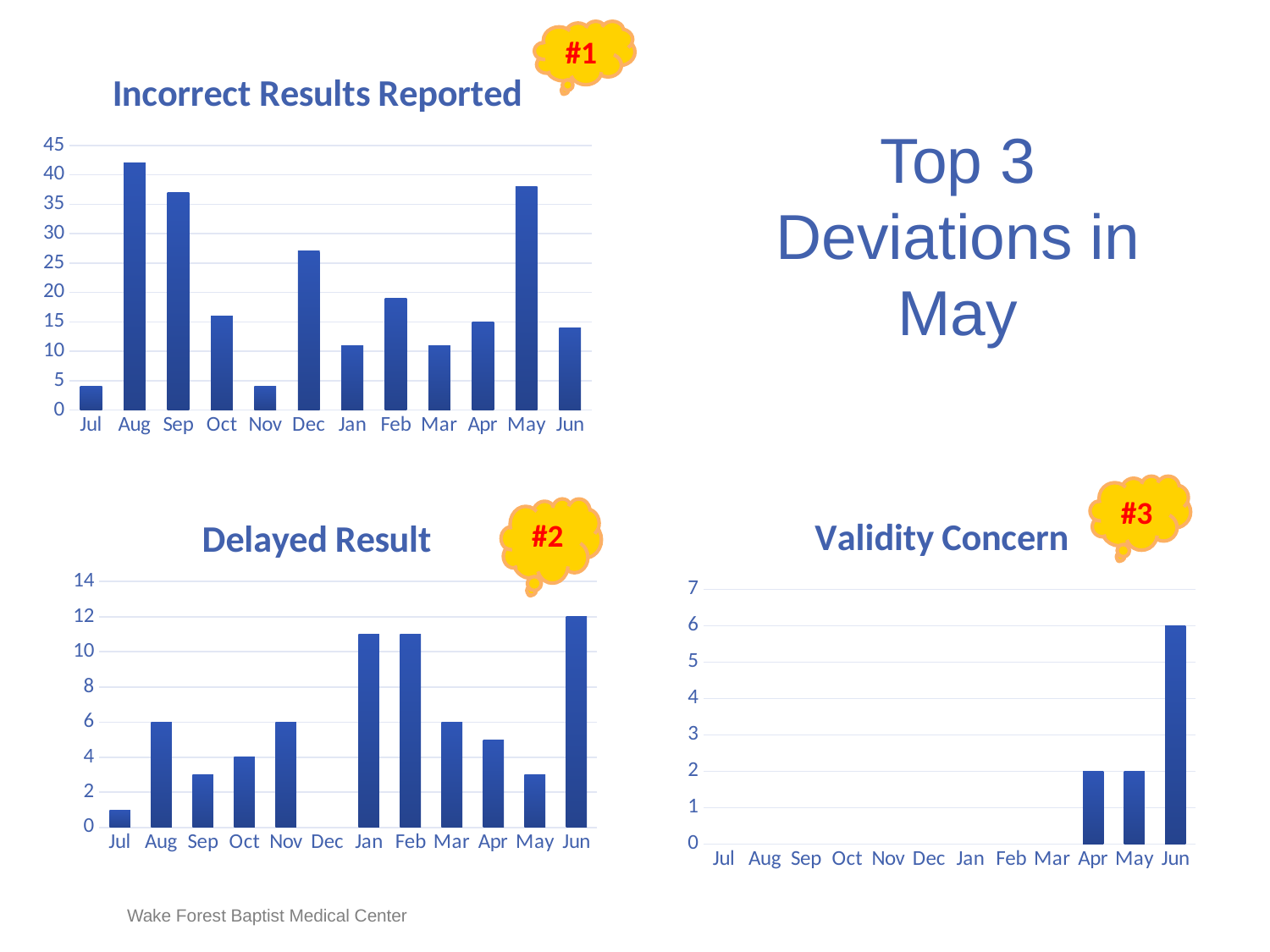
How many months are shown on the x axis of the 'Incorrect Results Reported' chart? 12 In the 'Delayed Result' chart, what is the value for Aug? 6 In the 'Incorrect Results Reported' chart, is the value for Jul greater or less than 10? less In the 'Validity Concern' chart, what is the value for Jun? 6 In the 'Validity Concern' chart, what is the difference between the values for Jun and Apr? 4 What type of chart is the 'Incorrect Results Reported' chart? bar chart In the 'Delayed Result' chart, which month has the highest value? Jun In the 'Incorrect Results Reported' chart, which is larger, the value for Dec or the value for Feb? Dec In the 'Delayed Result' chart, what is the value for Jun? 12 In the 'Incorrect Results Reported' chart, is the value for May greater or less than 35? greater In the 'Incorrect Results Reported' chart, which month has the highest value? Aug